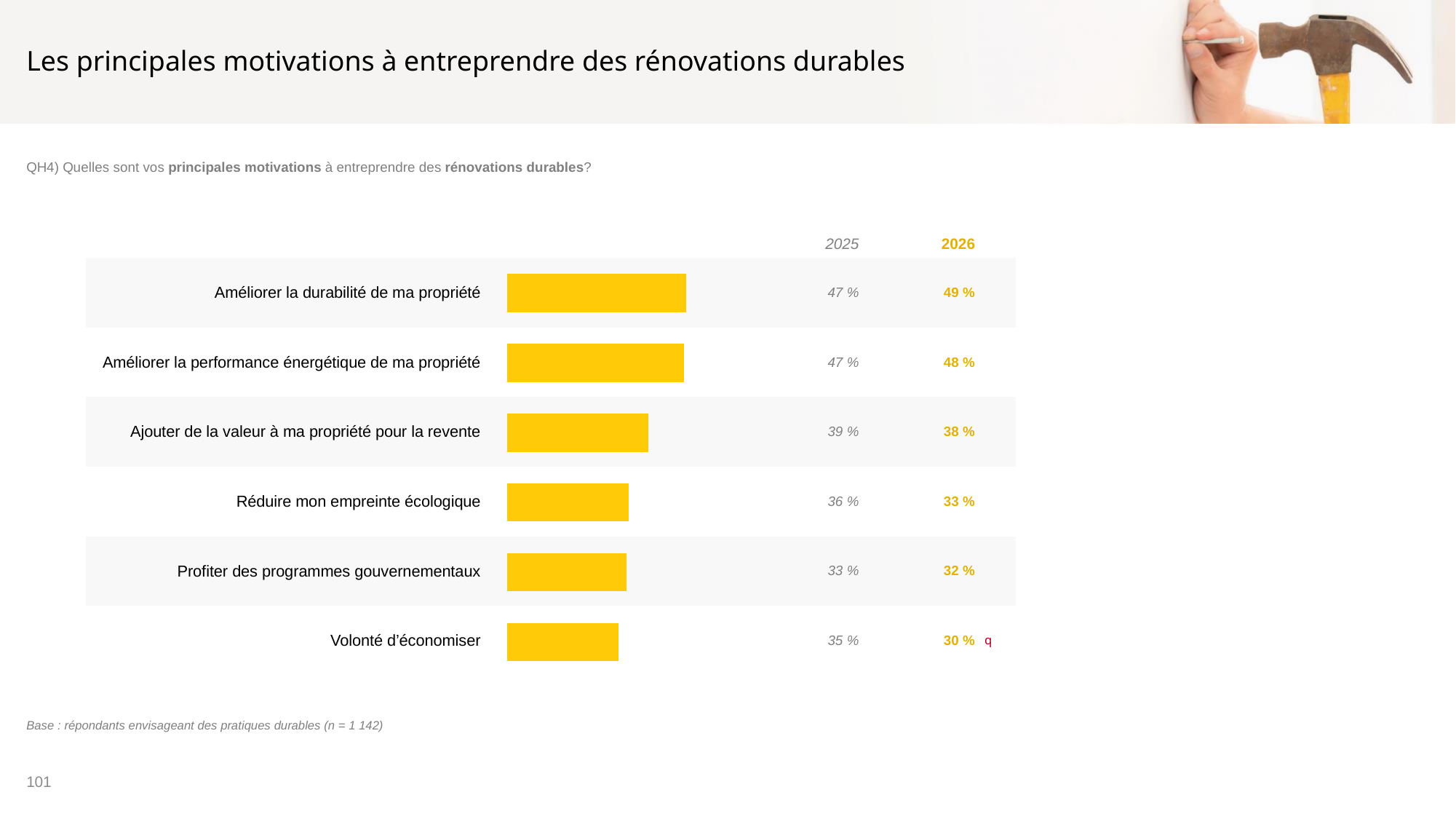
What is the difference between the 2026 values for "Améliorer la durabilité de ma propriété" and "Ajouter de la valeur à ma propriété pour la revente"? 11 % What is the difference between the 2025 and 2026 values for "Réduire mon empreinte écologique"? 3 % What is the 2026 value for "Améliorer la durabilité de ma propriété"? 49 % What kind of chart is shown on the slide? Bar chart Which motivation is marked with a red indicator next to its 2026 value? Volonté d'économiser What is the base size (n) stated at the bottom of the slide? n = 1 142 Which motivation has the lowest 2026 value? Volonté d'économiser How many motivations are listed in the chart? 6 What is the 2025 value for "Réduire mon empreinte écologique"? 36 % Which is larger in 2026: "Profiter des programmes gouvernementaux" or "Volonté d'économiser"? Profiter des programmes gouvernementaux What is the 2026 value for "Volonté d'économiser"? 30 % Which motivation has the highest 2026 value? Améliorer la durabilité de ma propriété